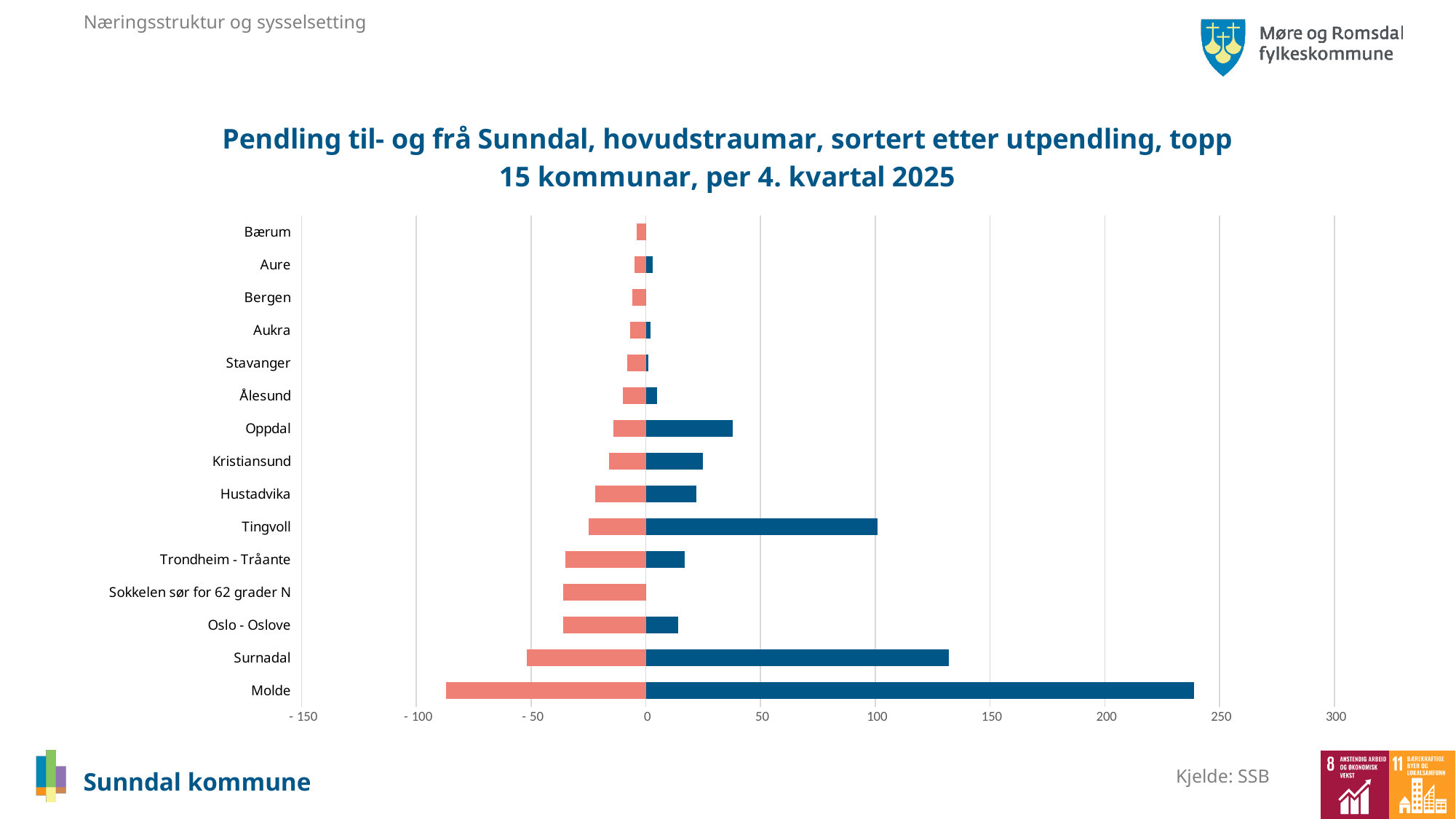
What is the title of the chart? Pendling til- og frå Sunndal, hovudstraumar, sortert etter utpendling, topp 15 kommunar, per 4. kvartal 2025 Is the red bar value for Molde greater or less than -50? less How many municipalities (categories) are listed on the vertical axis of the chart? 15 Which municipality has the longest red bar extending furthest to the left (lowest negative value)? Molde Is the blue bar value for Tingvoll greater or less than 50? greater Which has the larger blue bar, Surnadal or Tingvoll? Surnadal What are the minimum and maximum values shown on the horizontal axis? -150 and 300 Is the blue bar value for Molde greater or less than 200? greater Which municipality has the longest blue bar (highest positive value)? Molde What kind of chart is shown on the slide? Bar chart Which has the larger blue bar, Oppdal or Kristiansund? Oppdal